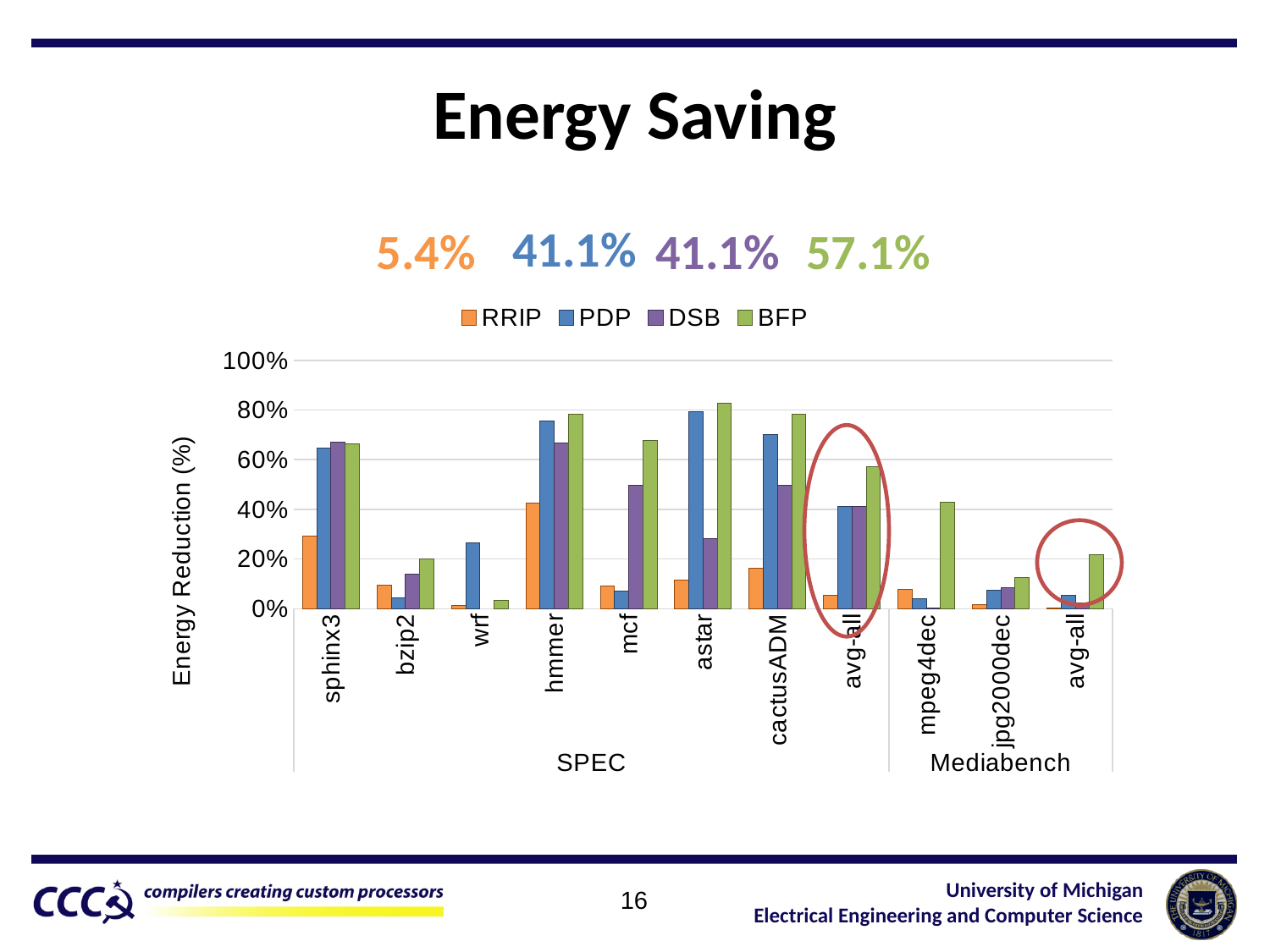
What is the BFP energy reduction for avg-all in the SPEC group? 57.1% Is the BFP value for astar greater or less than 80%? greater Is the BFP value for avg-all in the Mediabench group greater or less than 40%? less What is the label on the y axis? Energy Reduction (%) What is the PDP energy reduction for avg-all in the SPEC group? 41.1% For sphinx3, which is larger: the PDP value or the RRIP value? PDP Which series has the highest energy reduction for astar? BFP For avg-all in the SPEC group, what is the difference between the BFP and RRIP energy reductions? 51.7% How many benchmark categories are plotted along the x axis? 11 What kind of chart is shown on the slide? bar chart How many series does the legend list? 4 What is the RRIP energy reduction for avg-all in the SPEC group? 5.4%